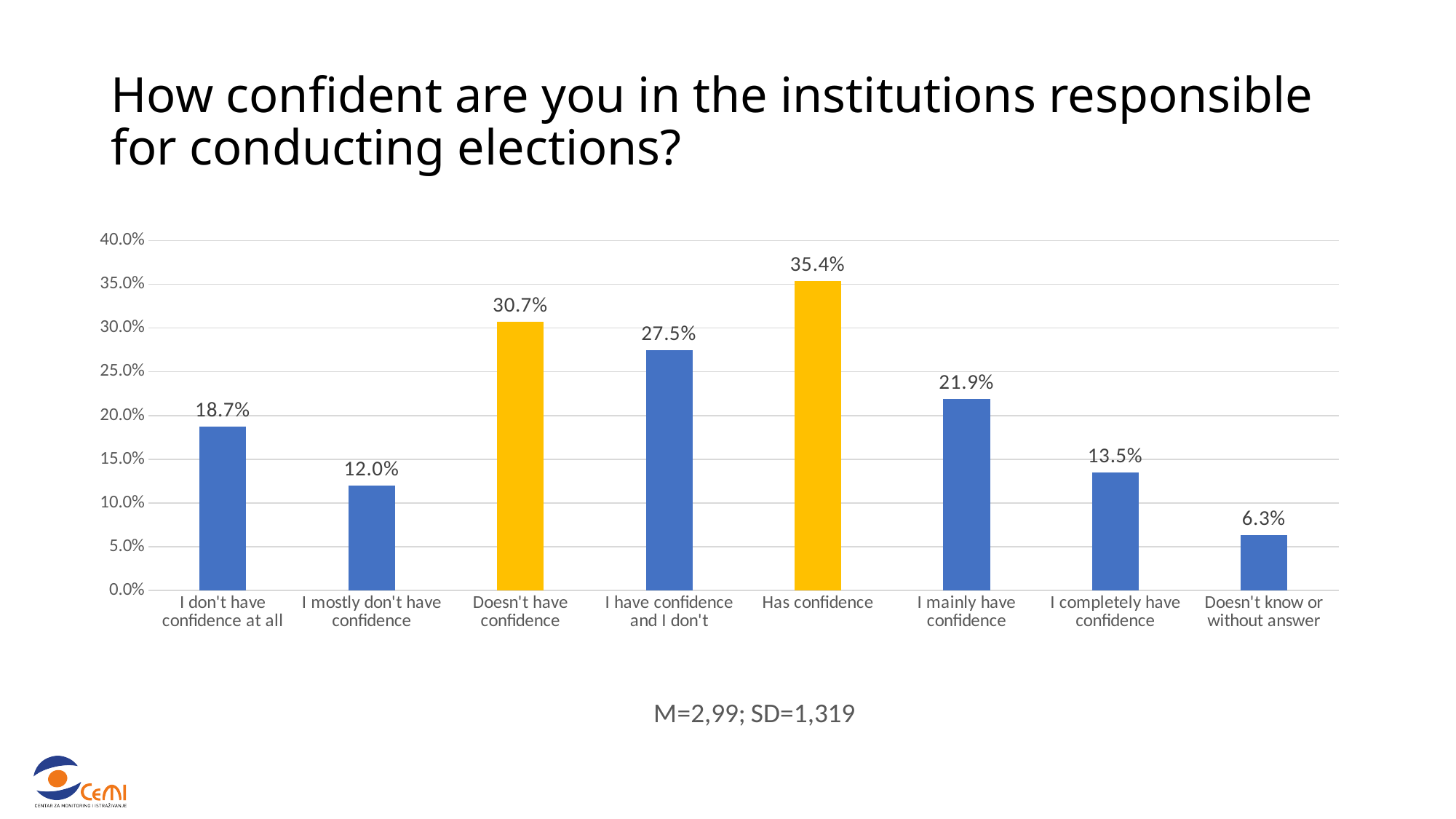
Which is larger: "I mainly have confidence" or "I have confidence and I don't"? I have confidence and I don't How many categories are shown on the x axis? 8 What is the difference between "Has confidence" and "Doesn't have confidence"? 4.7% What is the value for "I mostly don't have confidence"? 12.0% What is the value for "Has confidence"? 35.4% What is the value for "Doesn't know or without answer"? 6.3% Is the value for "I mainly have confidence" greater or less than 20.0%? greater Which category has the highest value? Has confidence Which two categories are shown with yellow bars? Doesn't have confidence and Has confidence Which category has the lowest value? Doesn't know or without answer What is the difference between "I don't have confidence at all" and "I completely have confidence"? 5.2% What kind of chart is shown on the slide? Bar chart